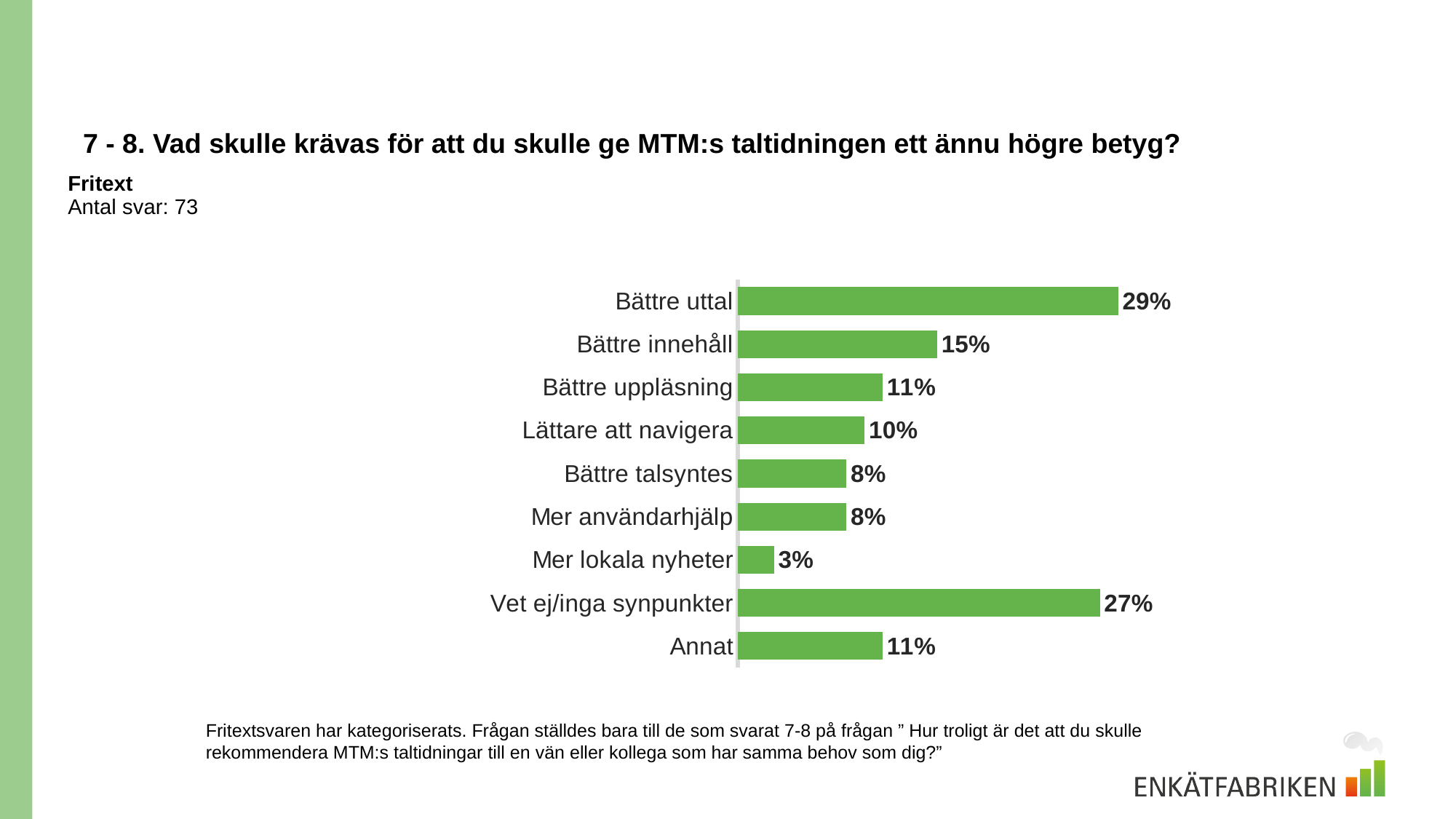
What is the value for Bättre uttal? 29% Which is larger, the value for Bättre innehåll or the value for Bättre uppläsning? Bättre innehåll What kind of chart is shown on the slide? Bar chart What is the value for Vet ej/inga synpunkter? 27% What is the value for Mer lokala nyheter? 3% How many categories are shown in the chart? 9 What is the value for Annat? 11% How many responses (Antal svar) does the slide report? 73 What is the value for Lättare att navigera? 10% Which category has the lowest value? Mer lokala nyheter What is the difference between the values for Bättre uttal and Bättre innehåll? 14% Which category has the highest value? Bättre uttal